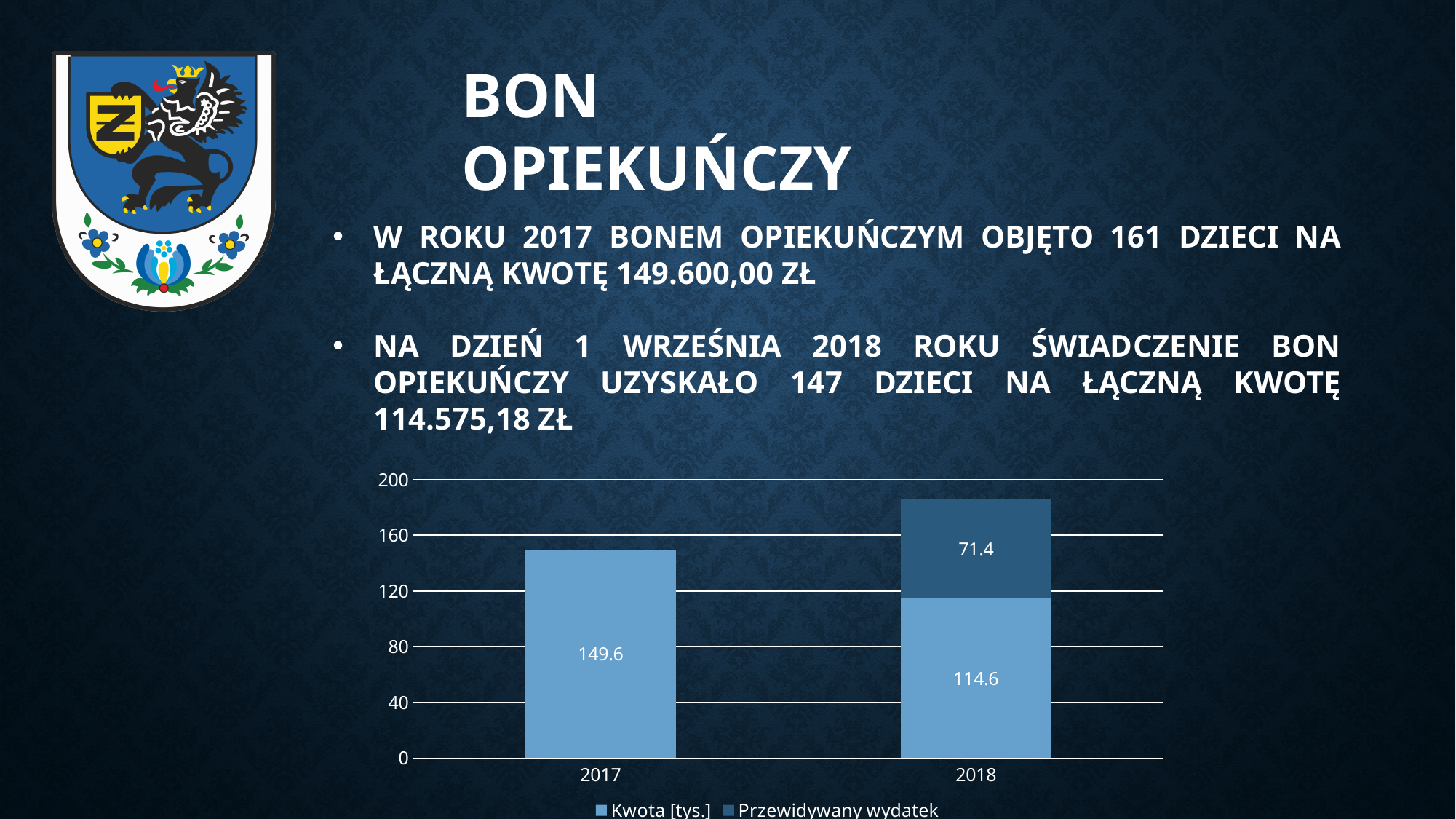
What is the difference between the Kwota [tys.] values for 2017 and 2018? 35 How many series does the legend list? 2 What is the total of the stacked bar for 2018? 186 Is the total height of the 2018 stacked bar greater or less than 160? greater What is the value of Przewidywany wydatek for 2018? 71.4 How many categories are shown on the x axis? 2 Does the Kwota [tys.] value rise or fall from 2017 to 2018? fall What are the two legend entries of the chart? Kwota [tys.] and Przewidywany wydatek What is the value of Kwota [tys.] for 2017? 149.6 Which year has the higher Kwota [tys.] value, 2017 or 2018? 2017 What type of chart is shown on the slide? bar chart What is the value of Kwota [tys.] for 2018? 114.6